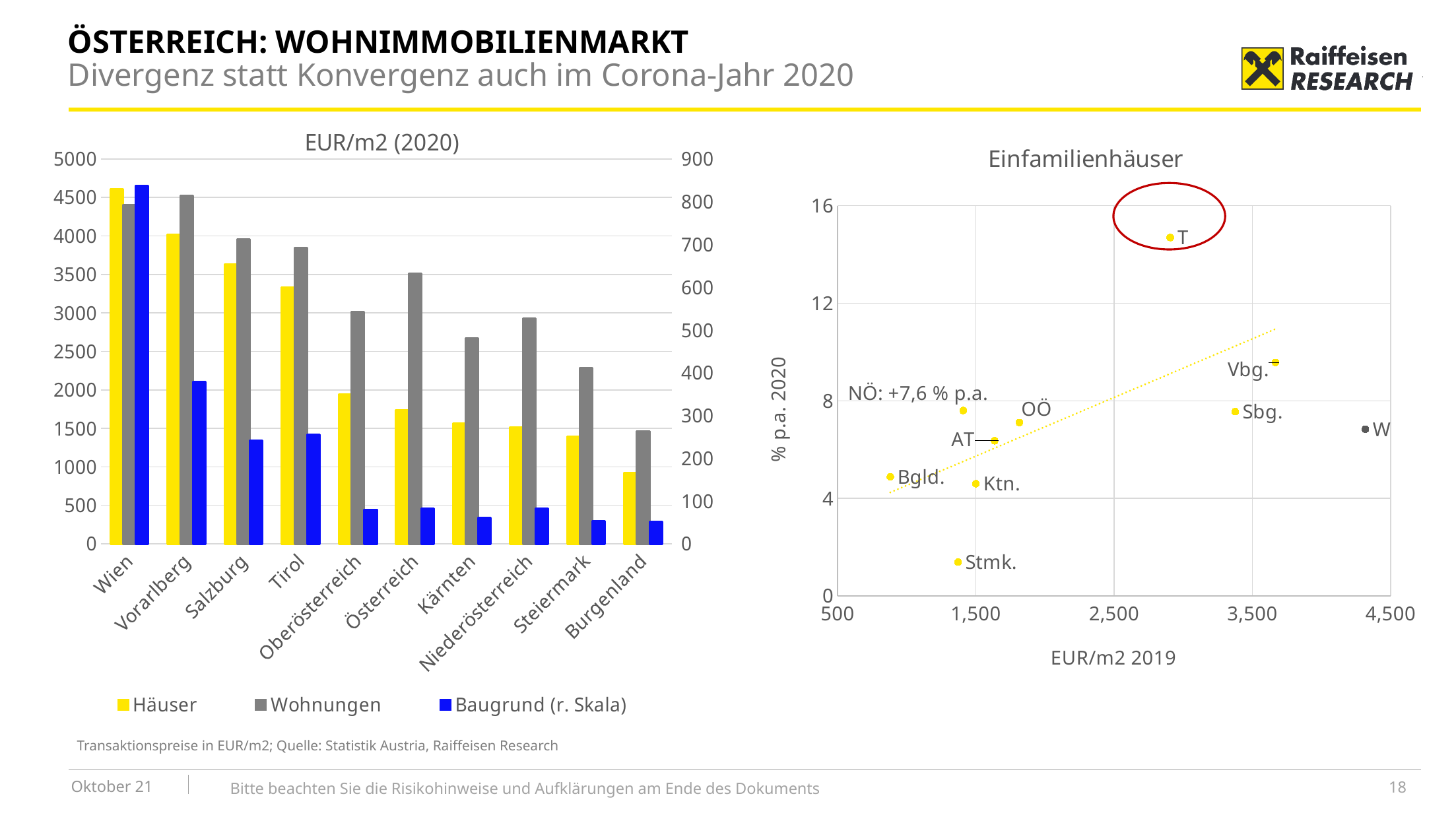
In the left chart "EUR/m2 (2020)", which region has the lowest Häuser value? Burgenland In the left chart "EUR/m2 (2020)", do the Häuser values generally rise or fall from Wien to Burgenland? fall In the left chart "EUR/m2 (2020)", how many regions are shown on the x axis? 10 In the left chart "EUR/m2 (2020)", how many series does the legend list? 3 In the left chart "EUR/m2 (2020)", which region has the highest Baugrund value? Wien In the left chart "EUR/m2 (2020)", for Vorarlberg, which is larger: Häuser or Wohnungen? Wohnungen In the right chart "Einfamilienhäuser", which point has the highest % p.a. 2020 value? T In the left chart "EUR/m2 (2020)", which region has the highest Häuser value? Wien In the left chart "EUR/m2 (2020)", is the Häuser value for Salzburg greater or less than 4000? less In the right chart "Einfamilienhäuser", what growth rate is printed for NÖ? +7,6 % p.a. What kind of chart is the left chart titled "EUR/m2 (2020)"? bar chart In the left chart "EUR/m2 (2020)", is the Wohnungen value for Tirol greater or less than 3500? greater